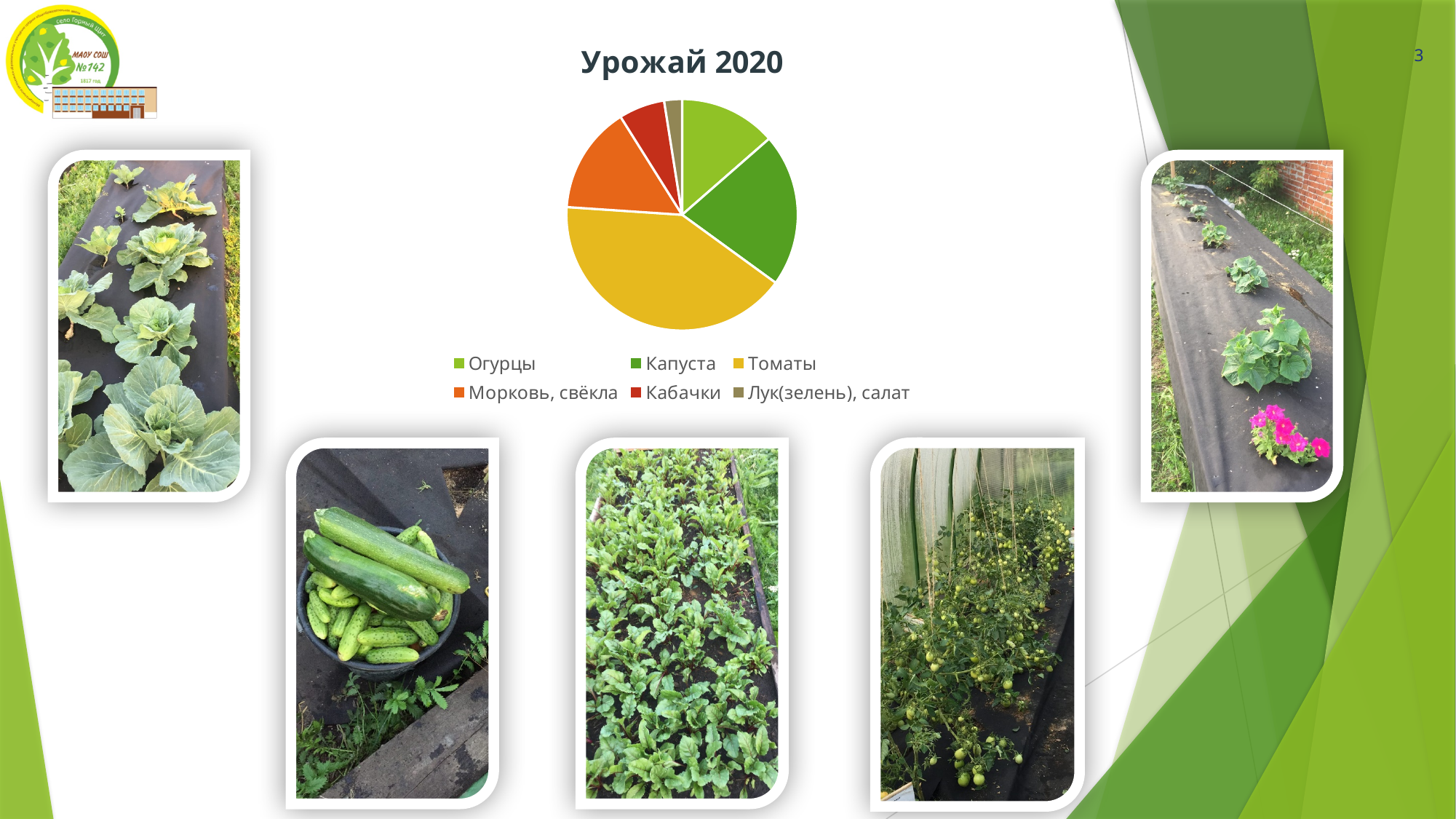
Which slice is larger, Кабачки or Лук(зелень), салат? Кабачки What kind of chart is shown on the slide? pie chart Which slice is larger, Морковь, свёкла or Кабачки? Морковь, свёкла What is the title of the chart? Урожай 2020 Which category has the largest slice of the pie? Томаты How many entries does the chart legend list? 6 How many slices does the pie chart have? 6 What colour is the Томаты slice in the pie chart? yellow Which slice is larger, Томаты or Капуста? Томаты Which category has the smallest slice of the pie? Лук(зелень), салат